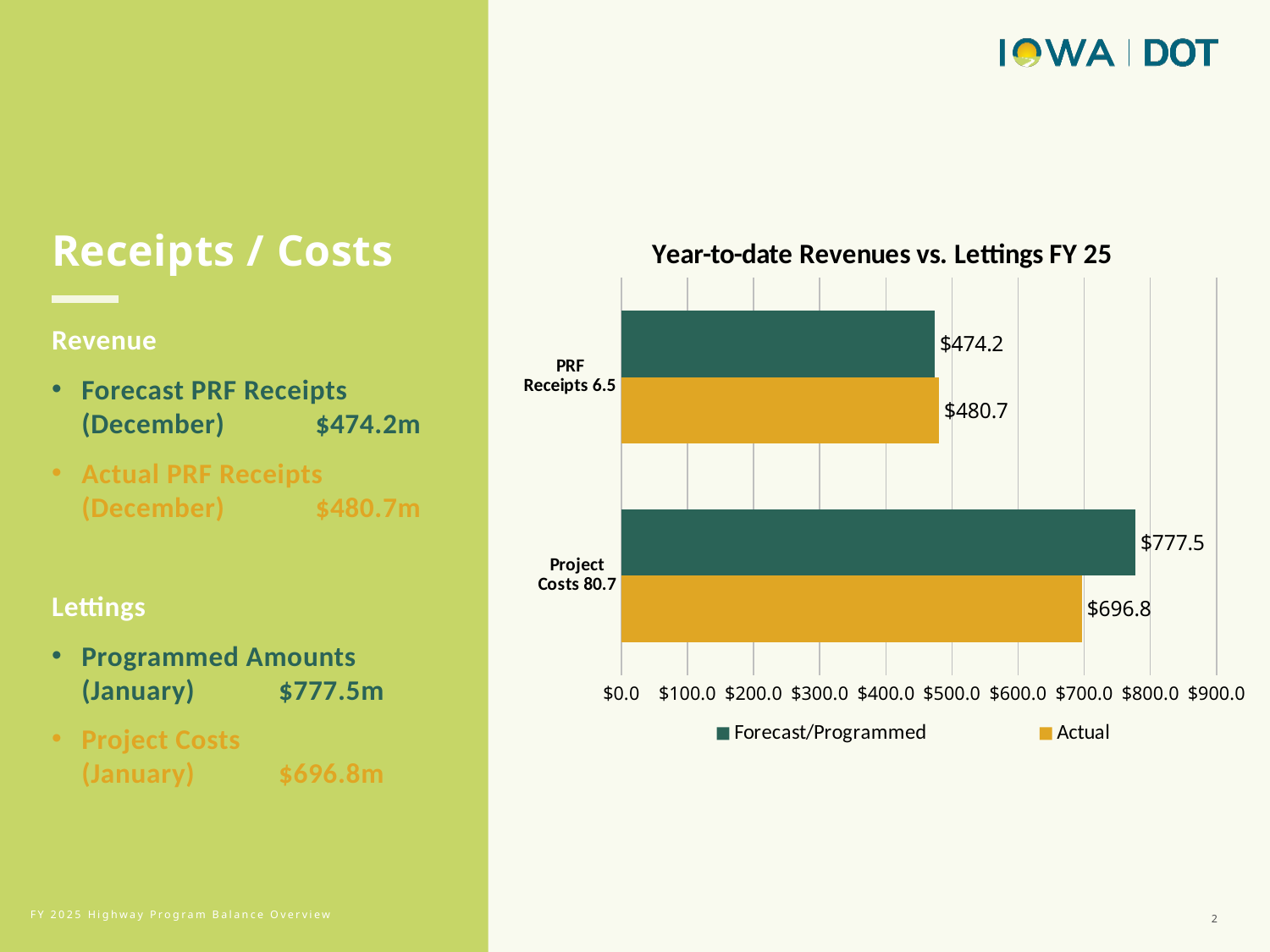
What is the title of the chart? Year-to-date Revenues vs. Lettings FY 25 Which bar has the highest value in the chart? Project Costs, Forecast/Programmed What kind of chart is shown on the slide? Bar chart How many series does the legend list? 2 What is the Actual value for PRF Receipts? $480.7 What is the Forecast/Programmed value for PRF Receipts? $474.2 Which bar has the lowest value in the chart? PRF Receipts, Forecast/Programmed What is the Actual value for Project Costs? $696.8 For Project Costs, which is larger: the Forecast/Programmed value or the Actual value? Forecast/Programmed What is the difference between the Forecast/Programmed and Actual values for Project Costs? $80.7 What is the difference between the Actual and Forecast/Programmed values for PRF Receipts? $6.5 What is the Forecast/Programmed value for Project Costs? $777.5